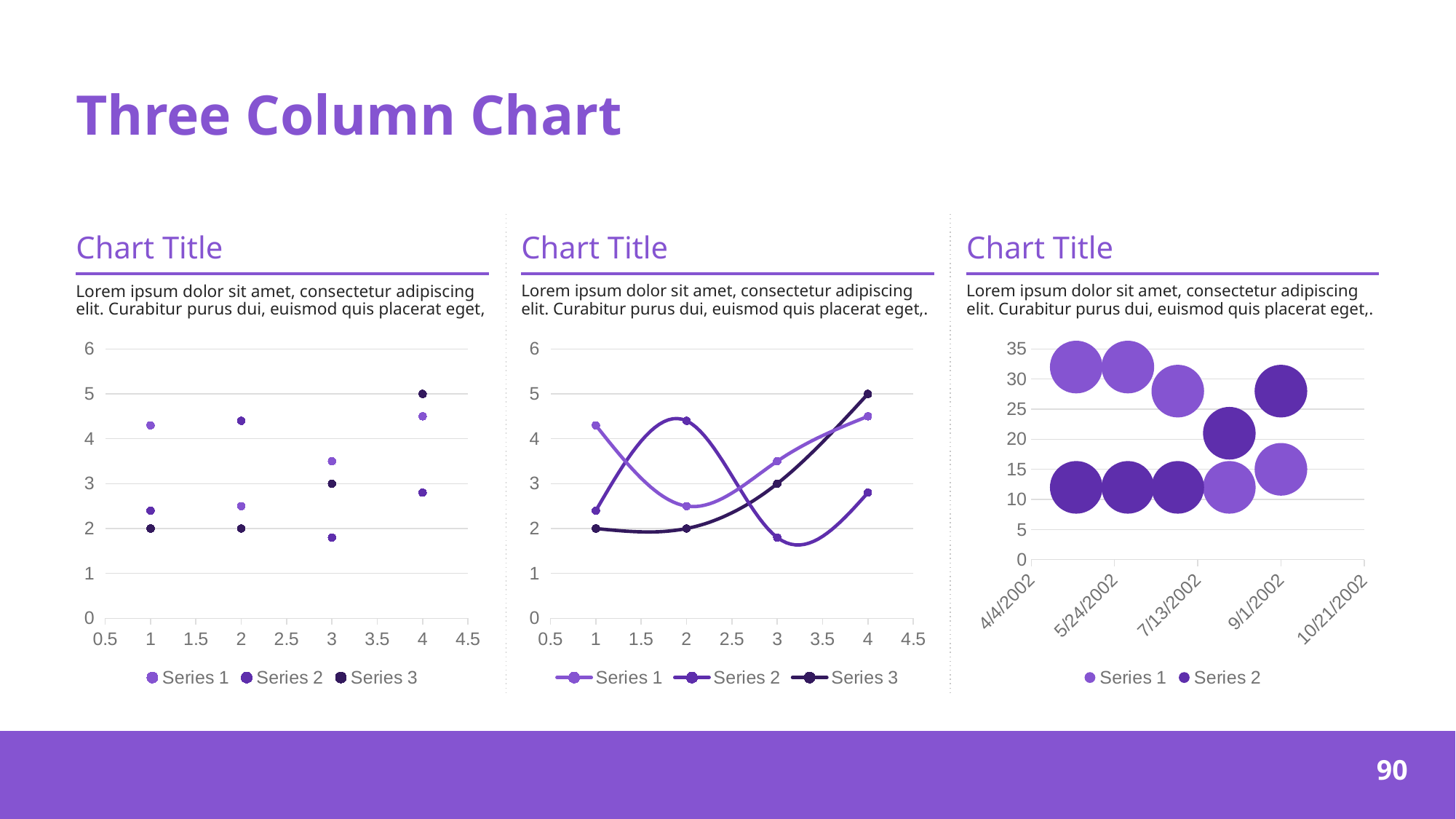
In the left chart, is the value of Series 1 at x = 4 greater or less than 4? greater In the middle chart, what is the value of Series 3 at x = 3? 3 How many data points does each series have in the left chart? 4 How many series does the legend of the right chart list? 2 In the middle chart, which series reaches the highest value? Series 3 How many series does the legend of the middle chart list? 3 What kind of chart is the right chart? bubble chart In the middle chart, does Series 3 rise or fall from x = 2 to x = 4? rise In the left chart, what is the value of Series 3 at x = 1? 2 In the left chart, what is the value of Series 3 at x = 4? 5 What kind of chart is the left chart? scatter chart